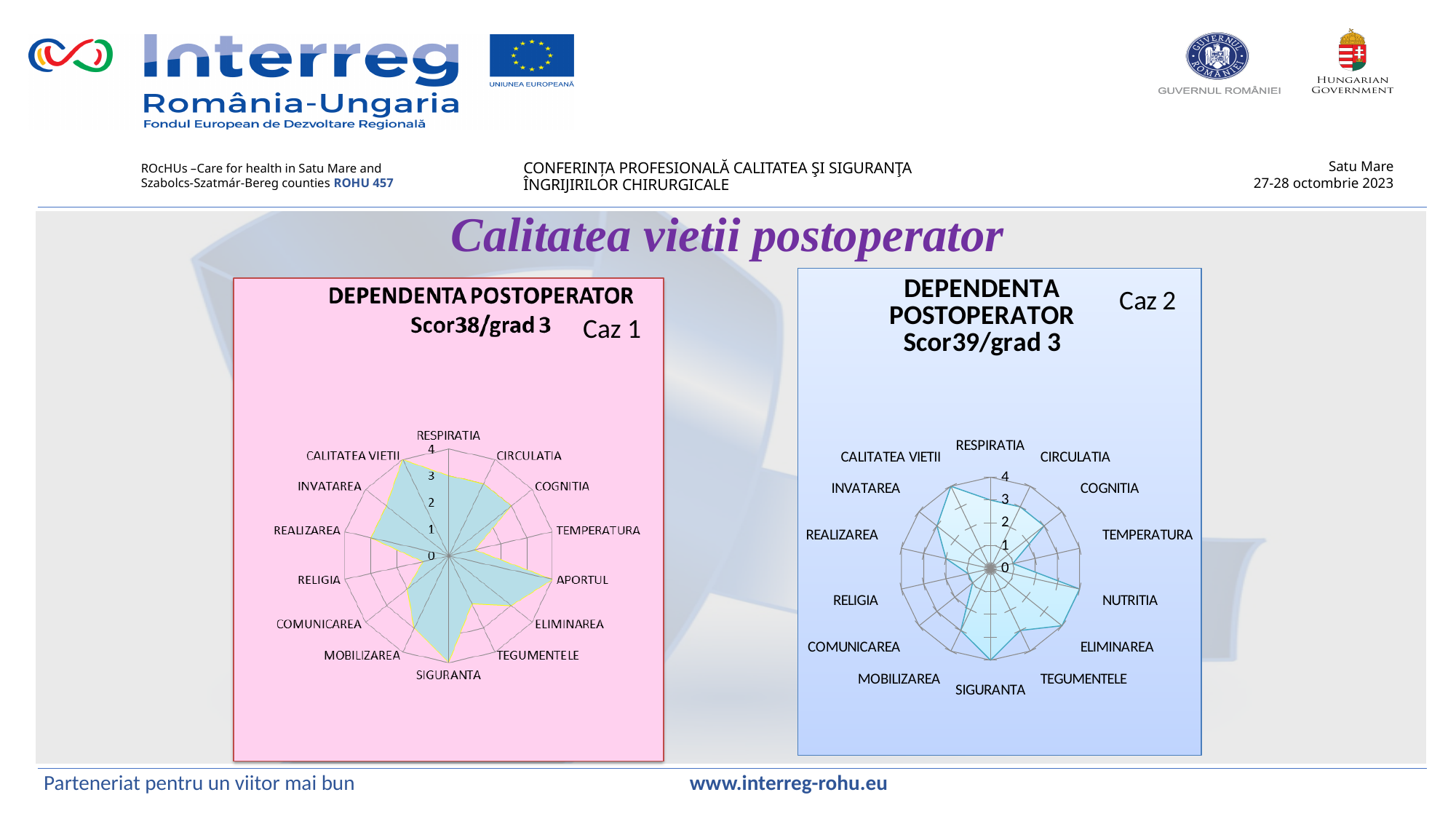
On the Caz 2 radar chart on the right, is the value for TEMPERATURA greater or less than 2? less What kind of chart is shown in the Caz 1 panel on the left? Radar chart On the Caz 2 radar chart on the right, is the value for SIGURANTA greater or less than 2? greater What score is stated in the title of the Caz 1 chart on the left? Scor38/grad 3 What kind of chart is shown in the Caz 2 panel on the right? Radar chart On the Caz 1 radar chart on the left, is the value for CALITATEA VIETII greater or less than 2? greater How many categories are plotted on the Caz 1 radar chart on the left? 14 How many categories are plotted on the Caz 2 radar chart on the right? 14 What score is stated in the title of the Caz 2 chart on the right? Scor39/grad 3